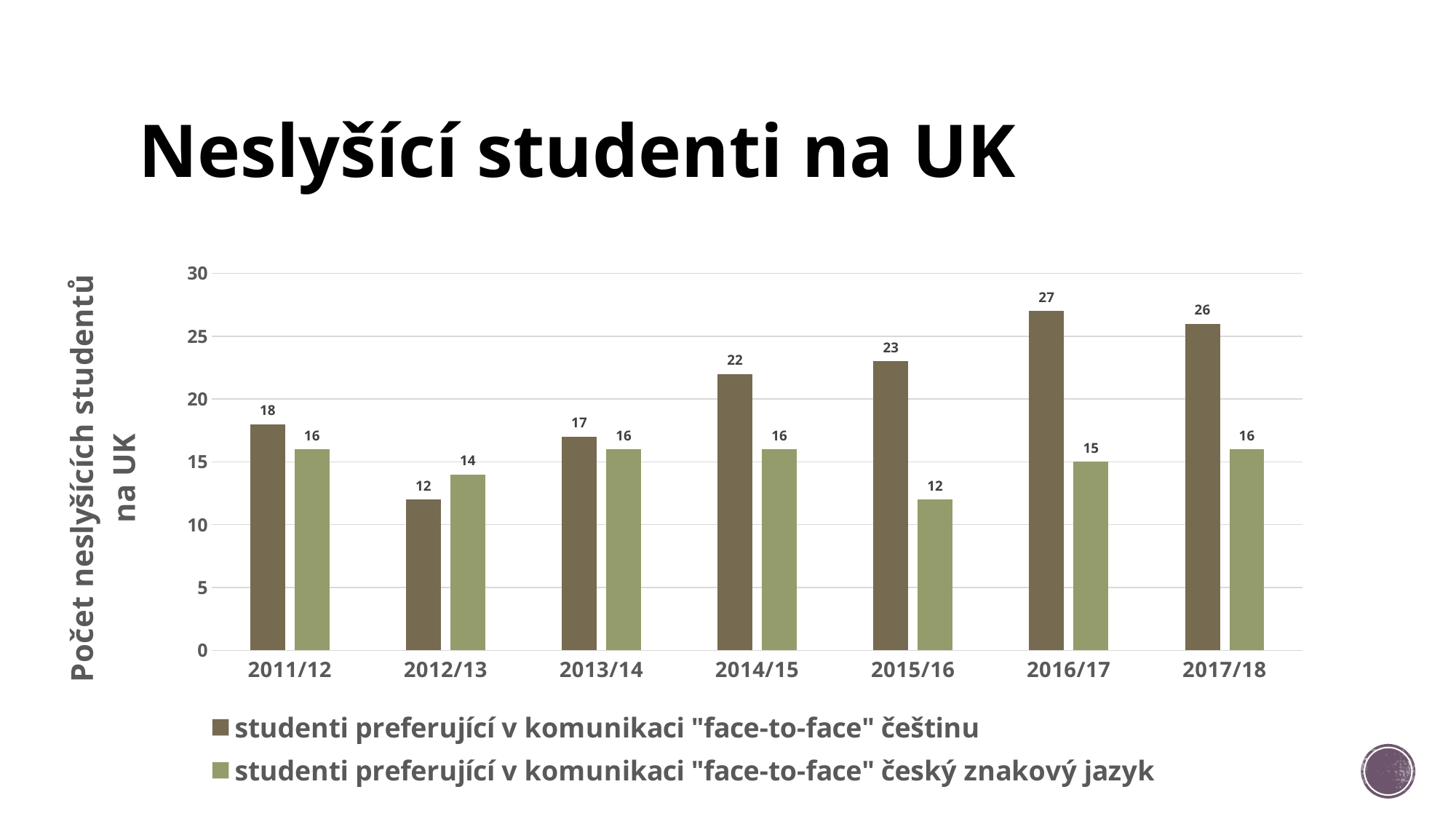
How many academic years are shown on the x axis? 7 How many series does the legend list? 2 How many deaf students preferring Czech sign language in face-to-face communication were there in 2012/13? 14 In 2012/13, which group was larger: students preferring Czech or students preferring Czech sign language? students preferring Czech sign language From 2013/14 to 2016/17, did the number of students preferring Czech in face-to-face communication rise or fall? rise What is the difference between students preferring Czech and students preferring Czech sign language in 2017/18? 10 What is the title of the slide? Neslyšící studenti na UK How many deaf students preferring Czech in face-to-face communication were there in 2016/17? 27 In which academic year was the number of students preferring Czech in face-to-face communication highest? 2016/17 In which academic year was the number of students preferring Czech in face-to-face communication lowest? 2012/13 In which academic year was the number of students preferring Czech sign language lowest? 2015/16 What kind of chart is shown on the slide? bar chart